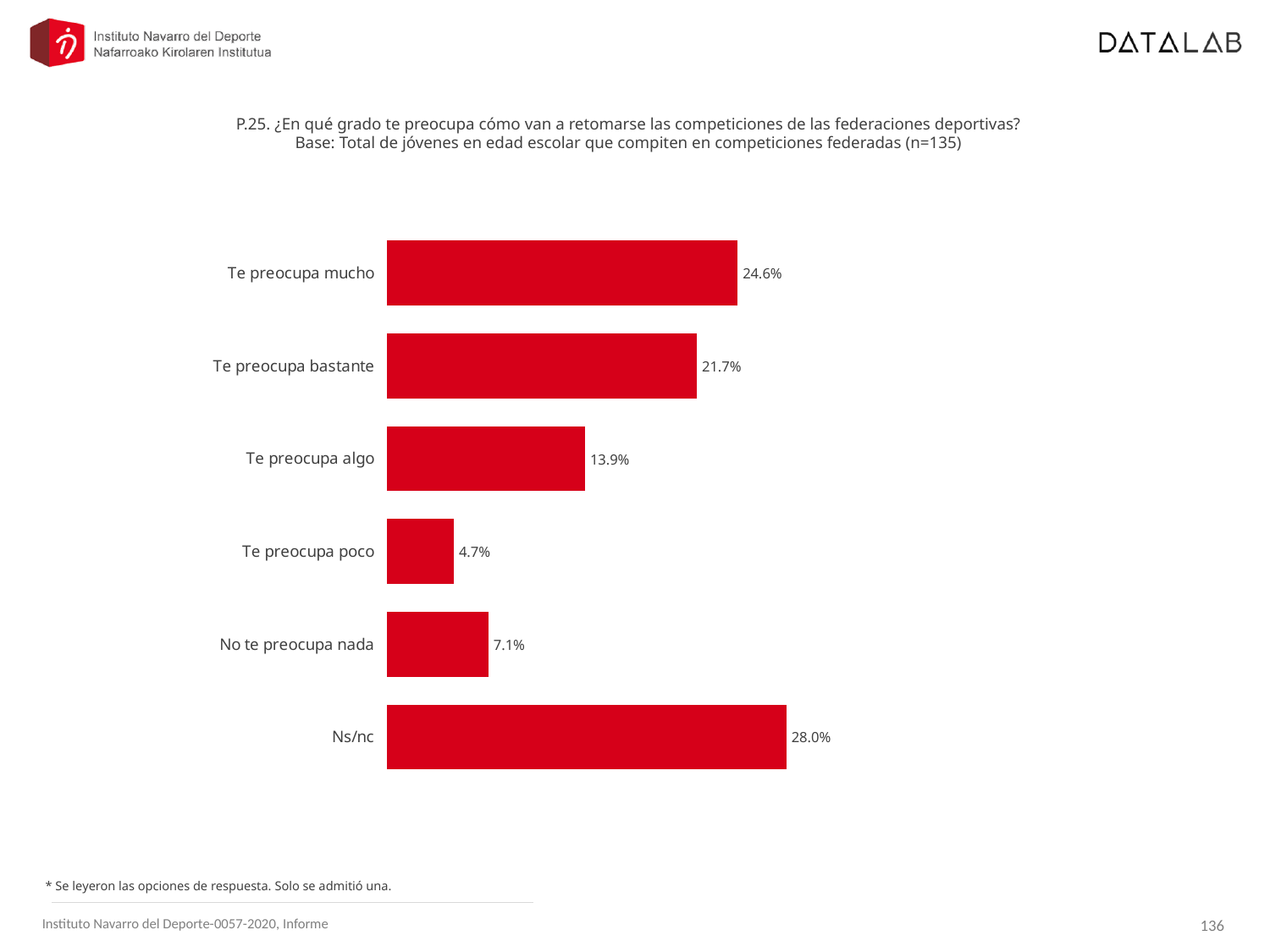
How many categories are shown in the chart? 6 What percentage is shown for "Te preocupa algo"? 13.9% What is the value shown for "Te preocupa bastante"? 21.7% Which is larger, "Te preocupa algo" or "No te preocupa nada"? Te preocupa algo Which category has the lowest value? Te preocupa poco What is the value for "No te preocupa nada"? 7.1% What is the difference between "No te preocupa nada" and "Te preocupa poco"? 2.4% What is the difference between "Te preocupa mucho" and "Te preocupa bastante"? 2.9% What is the sample size (n) stated in the chart's base line? 135 What type of chart is shown on the slide? Bar chart Which category has the highest value? Ns/nc What percentage of respondents answered "Te preocupa mucho"? 24.6%